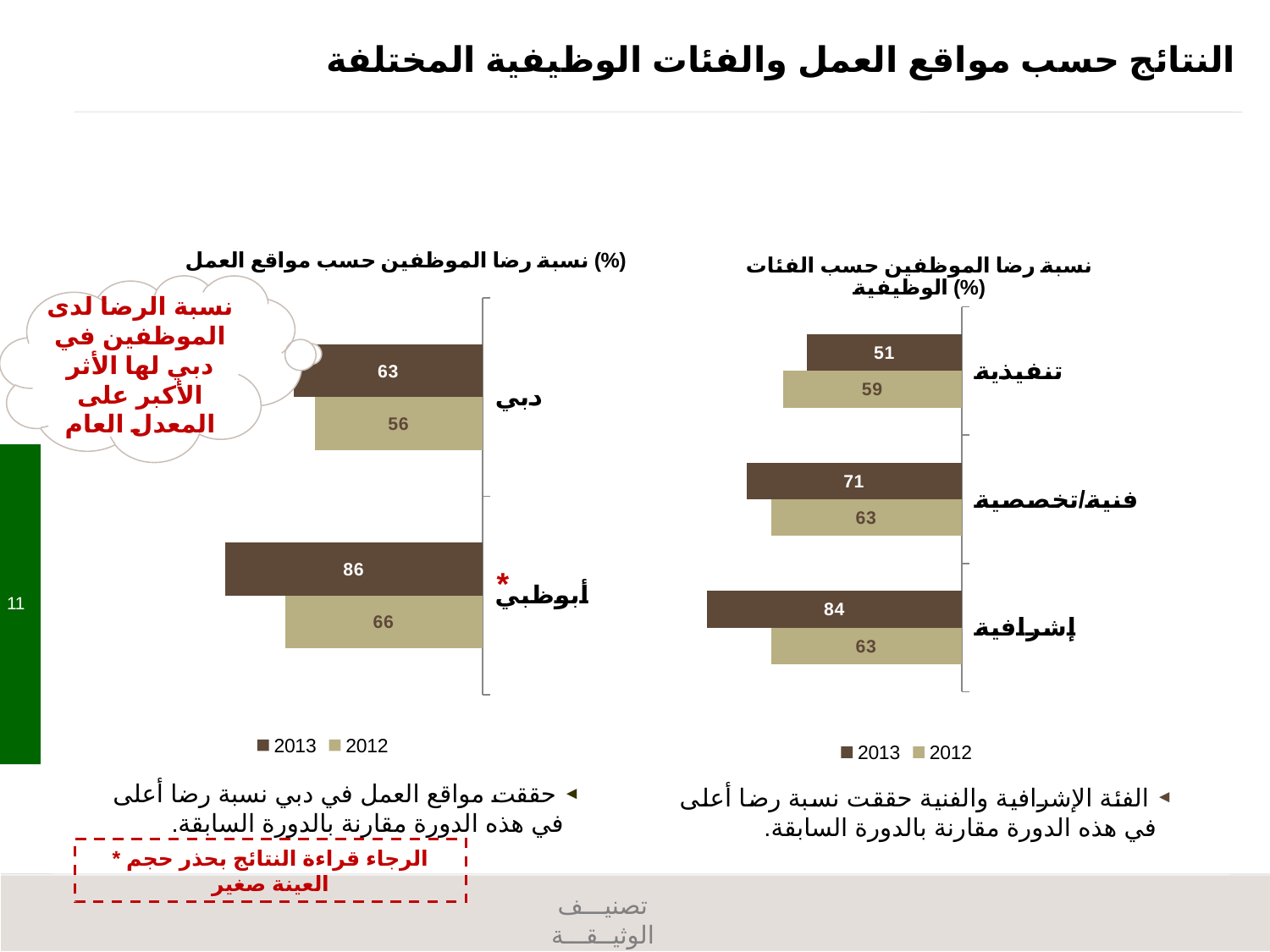
In the left chart (employee satisfaction by work location), how many series does the legend list? 2 In the left chart (employee satisfaction by work location), which location has the higher 2013 value? أبوظبي In the left chart (employee satisfaction by work location), what is the 2012 value for أبوظبي? 66 In the right chart (employee satisfaction by job category), how many job categories are shown? 3 In the right chart (employee satisfaction by job category), what is the difference between the 2013 and 2012 values for إشرافية? 21 In the left chart (employee satisfaction by work location), what is the difference between the 2013 and 2012 values for أبوظبي? 20 In the right chart (employee satisfaction by job category), what is the 2012 value for تنفيذية? 59 In the right chart (employee satisfaction by job category), what is the 2013 value for إشرافية? 84 In the right chart (employee satisfaction by job category), which category has the lowest 2013 value? تنفيذية In the right chart (employee satisfaction by job category), is the 2013 value for فنية/تخصصية larger or smaller than its 2012 value? larger In the left chart (employee satisfaction by work location), what is the 2013 value for دبي? 63 What type of chart is the left chart (employee satisfaction by work location)? bar chart